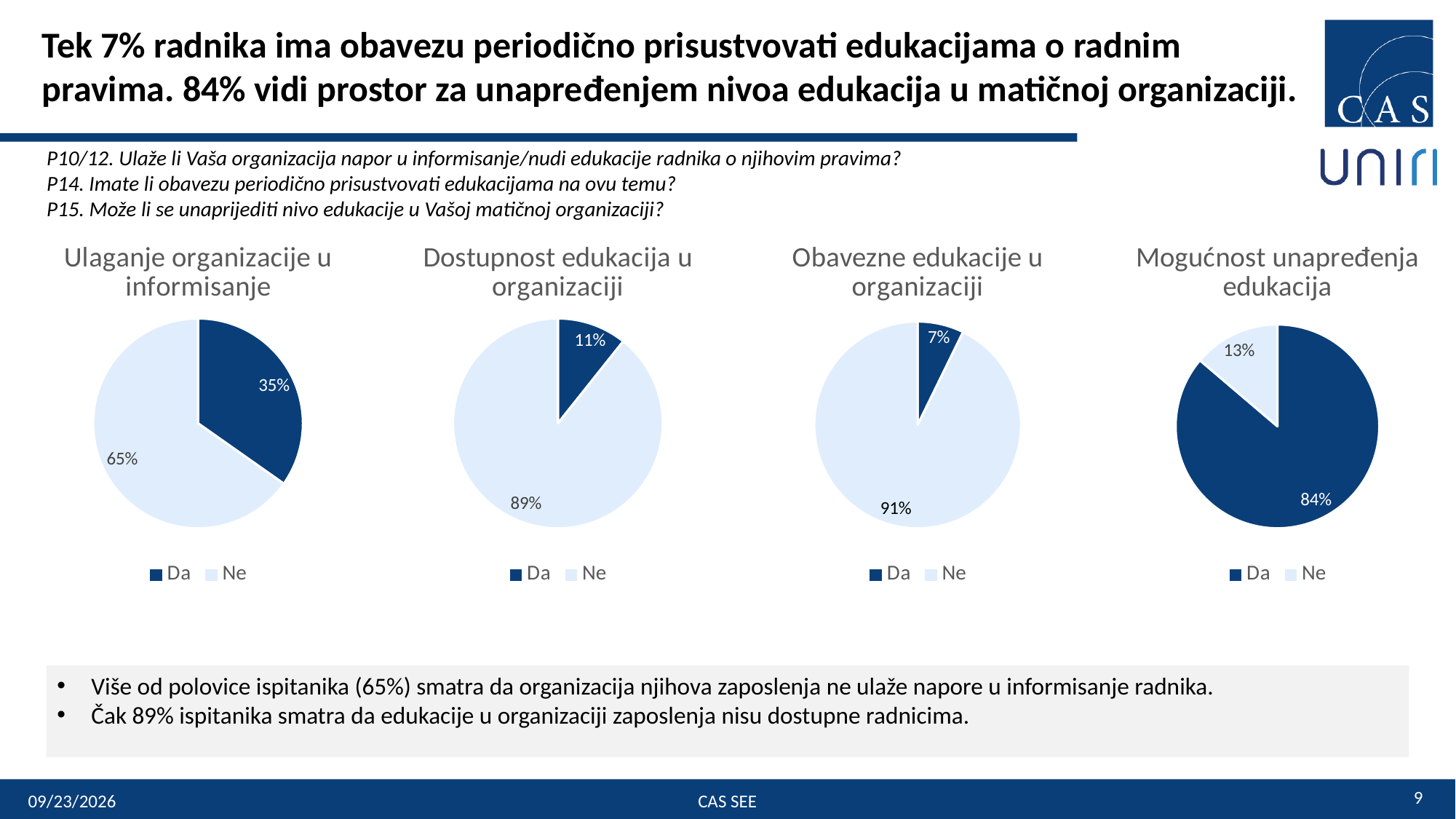
In the 'Obavezne edukacije u organizaciji' chart, what percentage is shown for 'Ne'? 91% What type of chart is 'Mogućnost unapređenja edukacija'? Pie chart In the 'Ulaganje organizacije u informisanje' chart, what percentage is shown for 'Ne'? 65% How many entries does the legend of the 'Dostupnost edukacija u organizaciji' chart list? 2 In the 'Dostupnost edukacija u organizaciji' chart, what percentage is shown for 'Da'? 11% In the 'Obavezne edukacije u organizaciji' chart, which slice is the smallest? Da In the 'Ulaganje organizacije u informisanje' chart, what percentage is shown for 'Da'? 35% In the 'Mogućnost unapređenja edukacija' chart, which slice is larger, 'Da' or 'Ne'? Da In the 'Ulaganje organizacije u informisanje' chart, what is the difference between the 'Ne' and 'Da' percentages? 30% In the 'Mogućnost unapređenja edukacija' chart, what percentage is shown for 'Da'? 84% In the 'Dostupnost edukacija u organizaciji' chart, what is the difference between the 'Ne' and 'Da' percentages? 78% How many slices does the 'Obavezne edukacije u organizaciji' chart have? 2